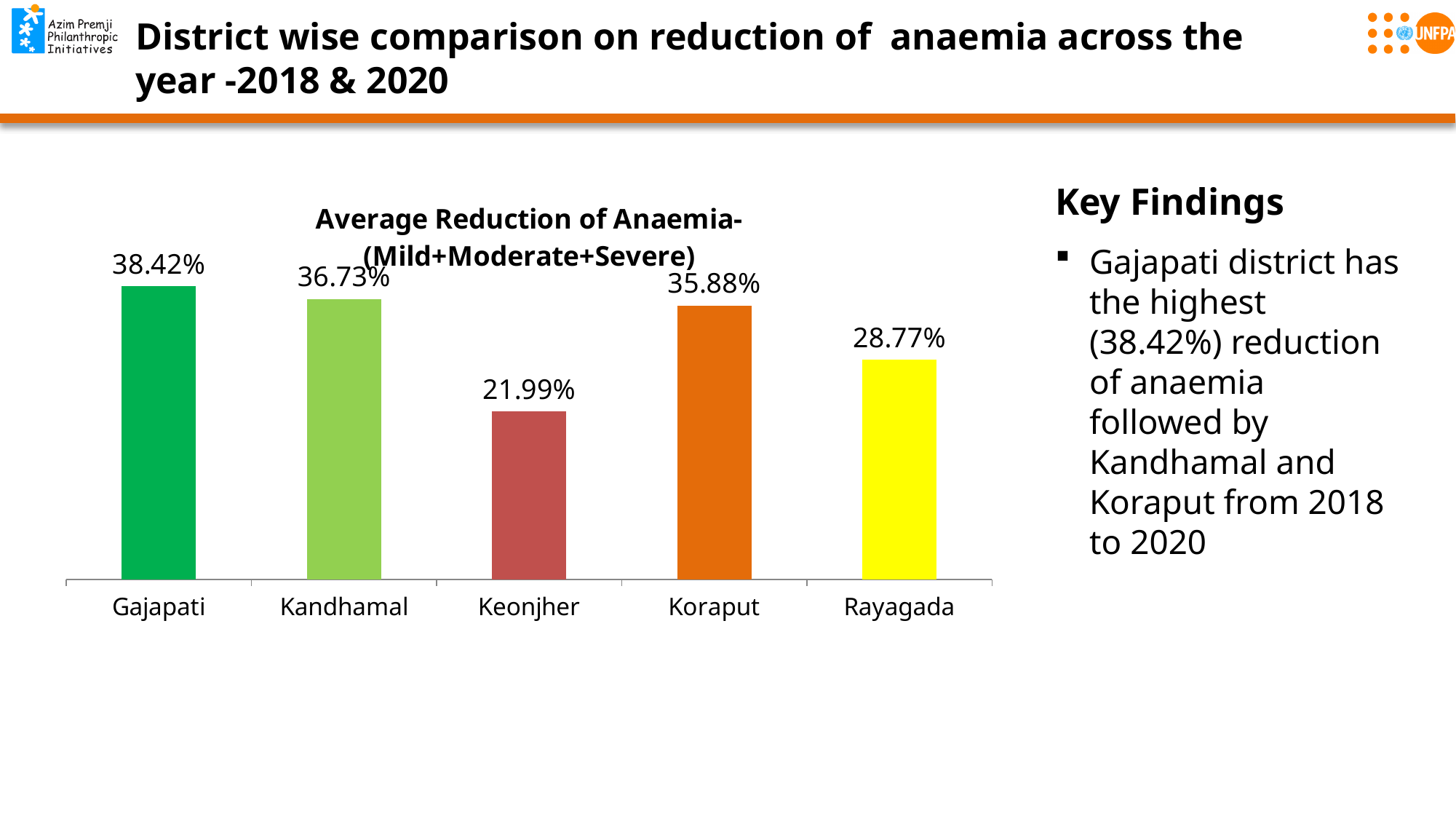
What type of chart is shown on the slide? Bar chart What is the average reduction of anaemia for Gajapati? 38.42% What is the difference between the reduction values for Kandhamal and Rayagada? 7.96% Which district has the highest average reduction of anaemia? Gajapati Which district has the lowest average reduction of anaemia? Keonjher What is the title of the chart? Average Reduction of Anaemia-(Mild+Moderate+Severe) What is the difference between the reduction values for Gajapati and Keonjher? 16.43% Which district has a larger reduction of anaemia, Koraput or Rayagada? Koraput How many districts are shown in the chart? 5 What is the average reduction of anaemia for Koraput? 35.88% What is the average reduction of anaemia for Rayagada? 28.77% What is the average reduction of anaemia for Keonjher? 21.99%